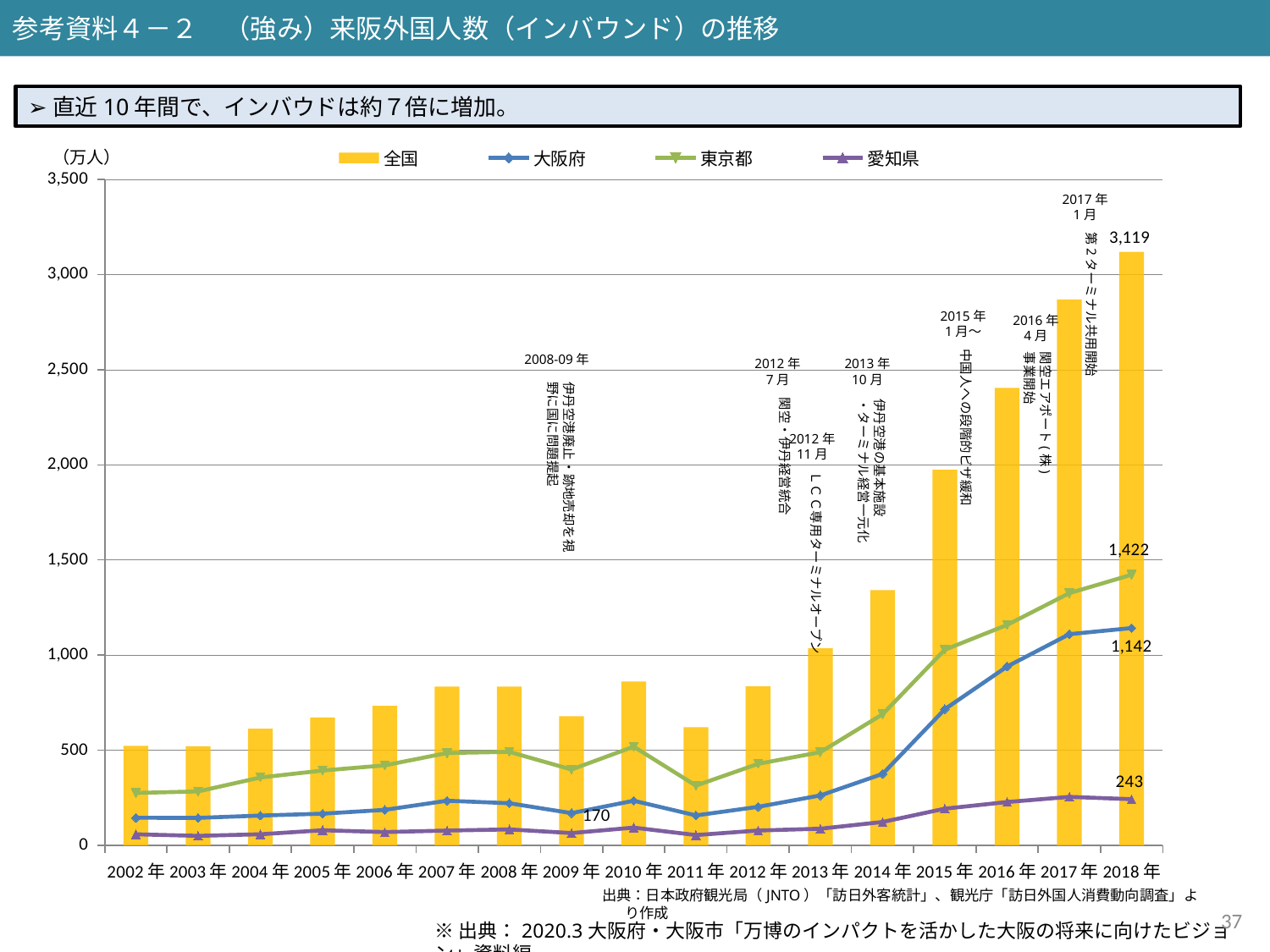
Which is larger in 2018年, the value for 東京都 or the value for 大阪府? 東京都 Which series is shown as bars rather than a line? 全国 What is the value for 愛知県 in 2018年? 243 Is the value for 全国 in 2015年 greater or less than 1,500? greater What is the difference between the 東京都 and 大阪府 values in 2018年? 280 What is the value for 大阪府 in 2009年? 170 Is the value for 東京都 in 2014年 greater or less than 1,000? less What is the value for 大阪府 in 2018年? 1,142 How many series does the legend list? 4 What is the value for 全国 in 2018年? 3,119 What is the value for 東京都 in 2018年? 1,422 How many years are shown on the x axis? 17